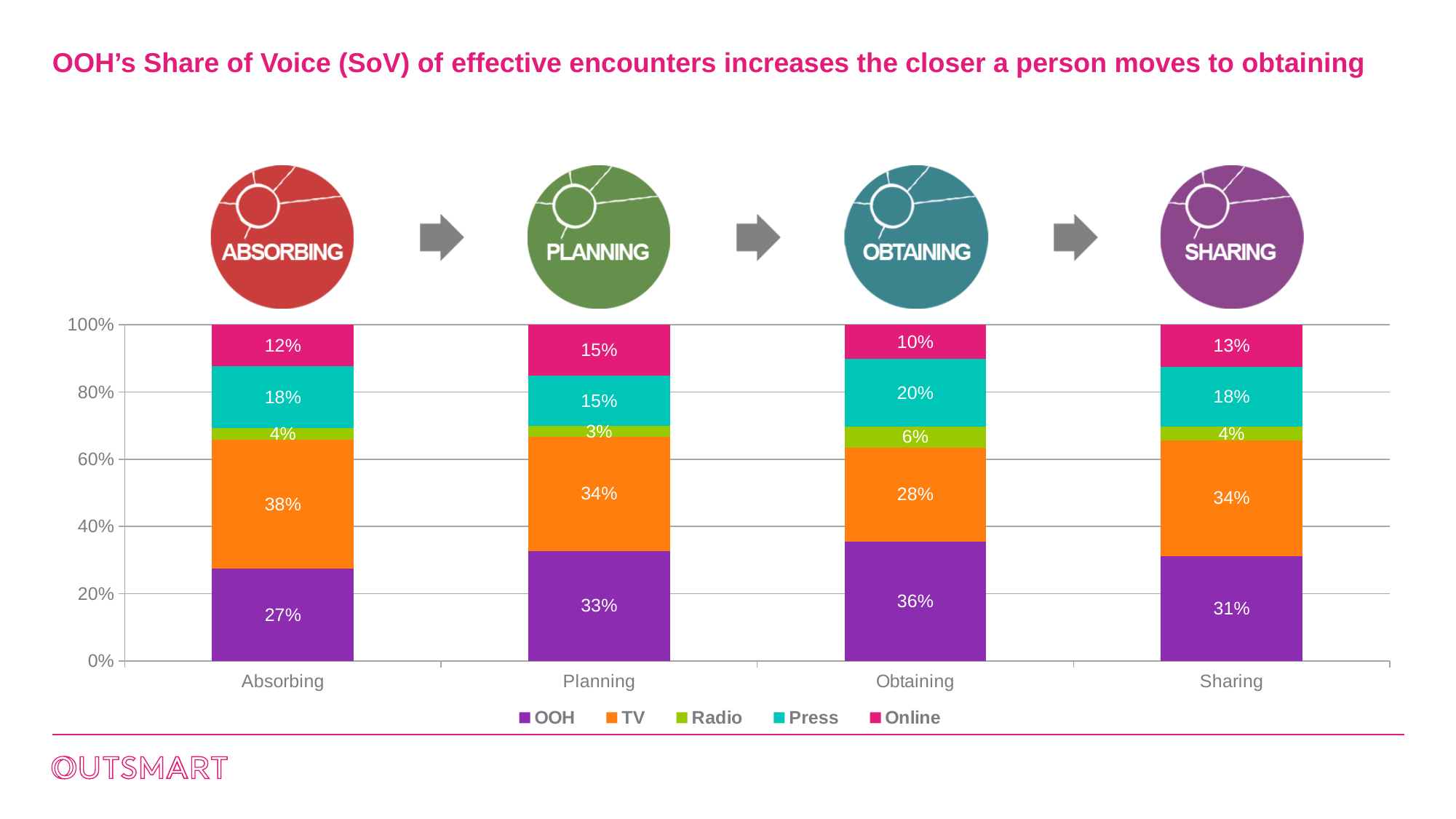
Which stage has the highest OOH value? Obtaining What is the OOH value for Obtaining? 36% Which stage has the lowest Radio value? Planning What kind of chart is shown? Stacked bar chart What is the difference between the TV value for Absorbing and the TV value for Obtaining? 10% Which colour represents TV in the chart? Orange Which is larger, the Press value for Obtaining or the Online value for Obtaining? Press How many stages are shown on the x axis? 4 What is the Press value for Planning? 15% How many series does the legend list? 5 What is the TV value for Absorbing? 38% What is the Online value for Sharing? 13%